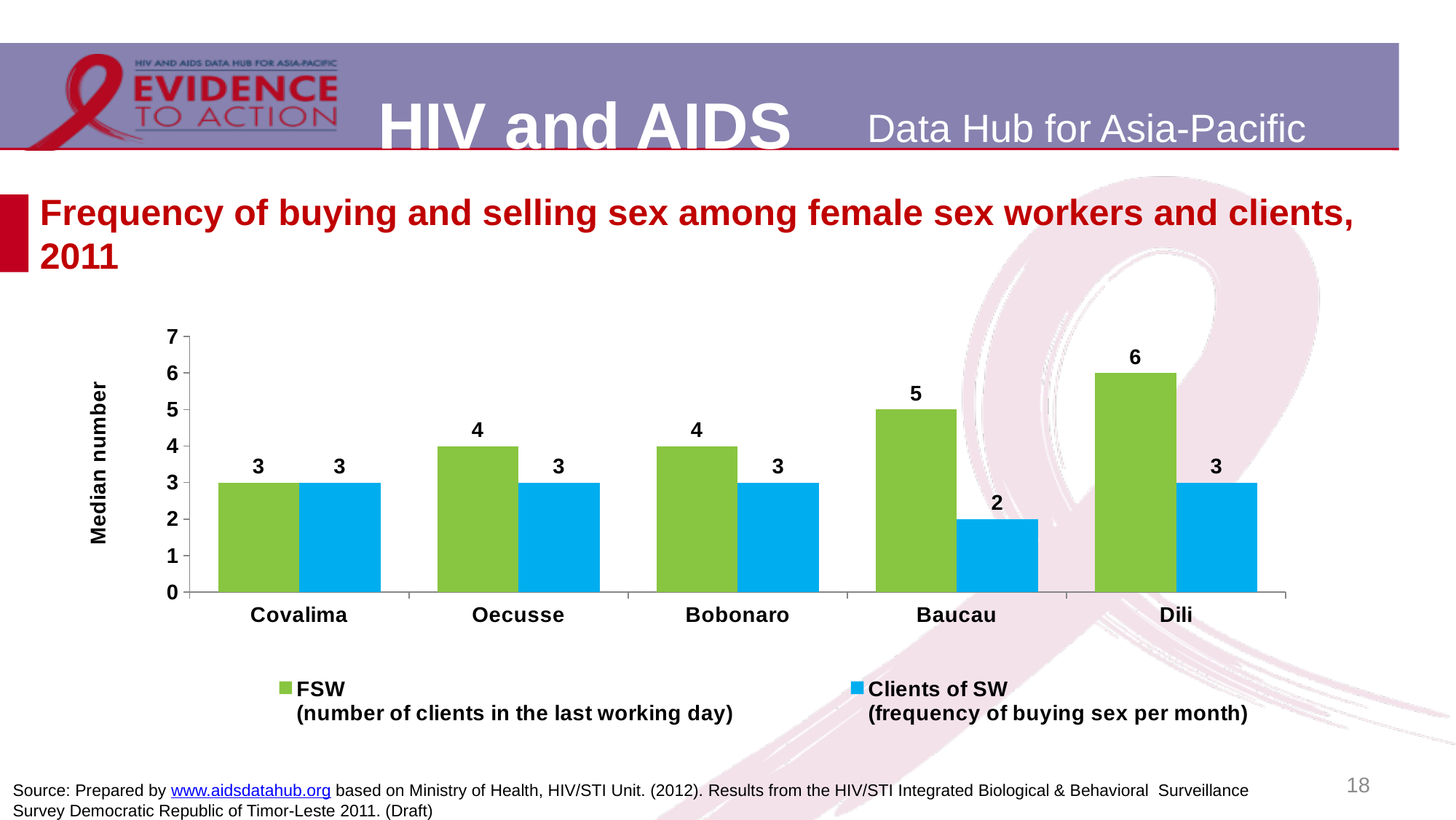
Do the FSW values rise or fall from Covalima to Dili? Rise What is the Clients of SW value for Baucau? 2 What kind of chart is shown on the slide? Bar chart Which district has the highest FSW value? Dili What is the label of the y axis? Median number How many districts are shown on the x axis? 5 How many series does the legend list? 2 What is the difference between the FSW and Clients of SW values for Baucau? 3 What is the FSW value for Dili? 6 Which is larger for Bobonaro, the FSW value or the Clients of SW value? FSW What is the FSW value for Oecusse? 4 Which district has the lowest Clients of SW value? Baucau